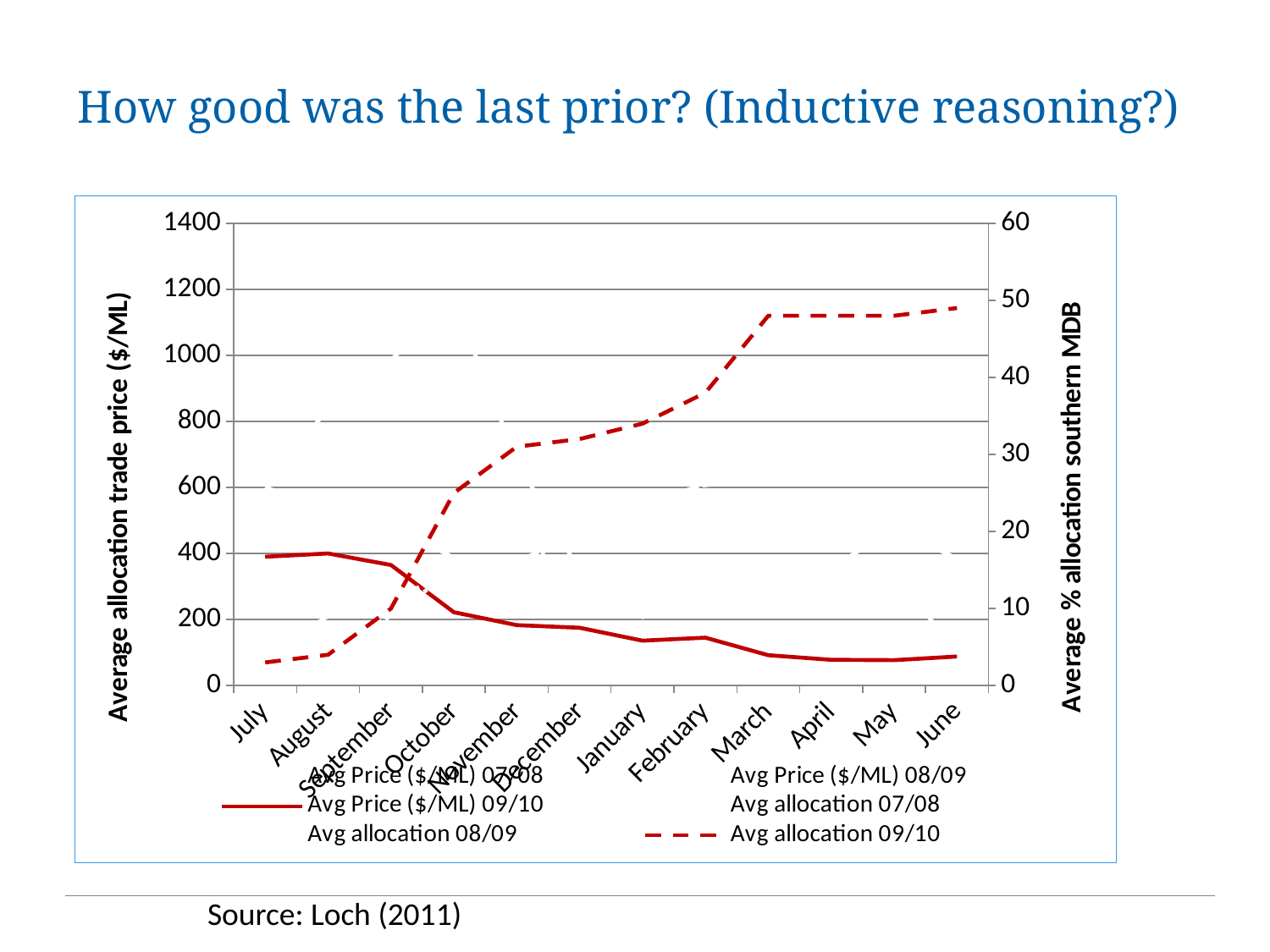
Is the value of Avg Price ($/ML) 09/10 in July greater or less than 200? greater What is the title of the chart's left vertical axis? Average allocation trade price ($/ML) Is the value of Avg allocation 09/10 in July greater or less than 10? less How many months are shown along the x axis of the chart? 12 Does the Avg allocation 09/10 line rise or fall from July to June? rise What kind of chart is shown on the slide? line chart How many series does the chart's legend list? 6 Does the Avg Price ($/ML) 09/10 line rise or fall from July to June? fall Is the value of Avg allocation 09/10 in March greater or less than 40? greater Which is larger for Avg Price ($/ML) 09/10: the value in July or the value in June? July Which is larger for Avg allocation 09/10: the value in October or the value in March? March